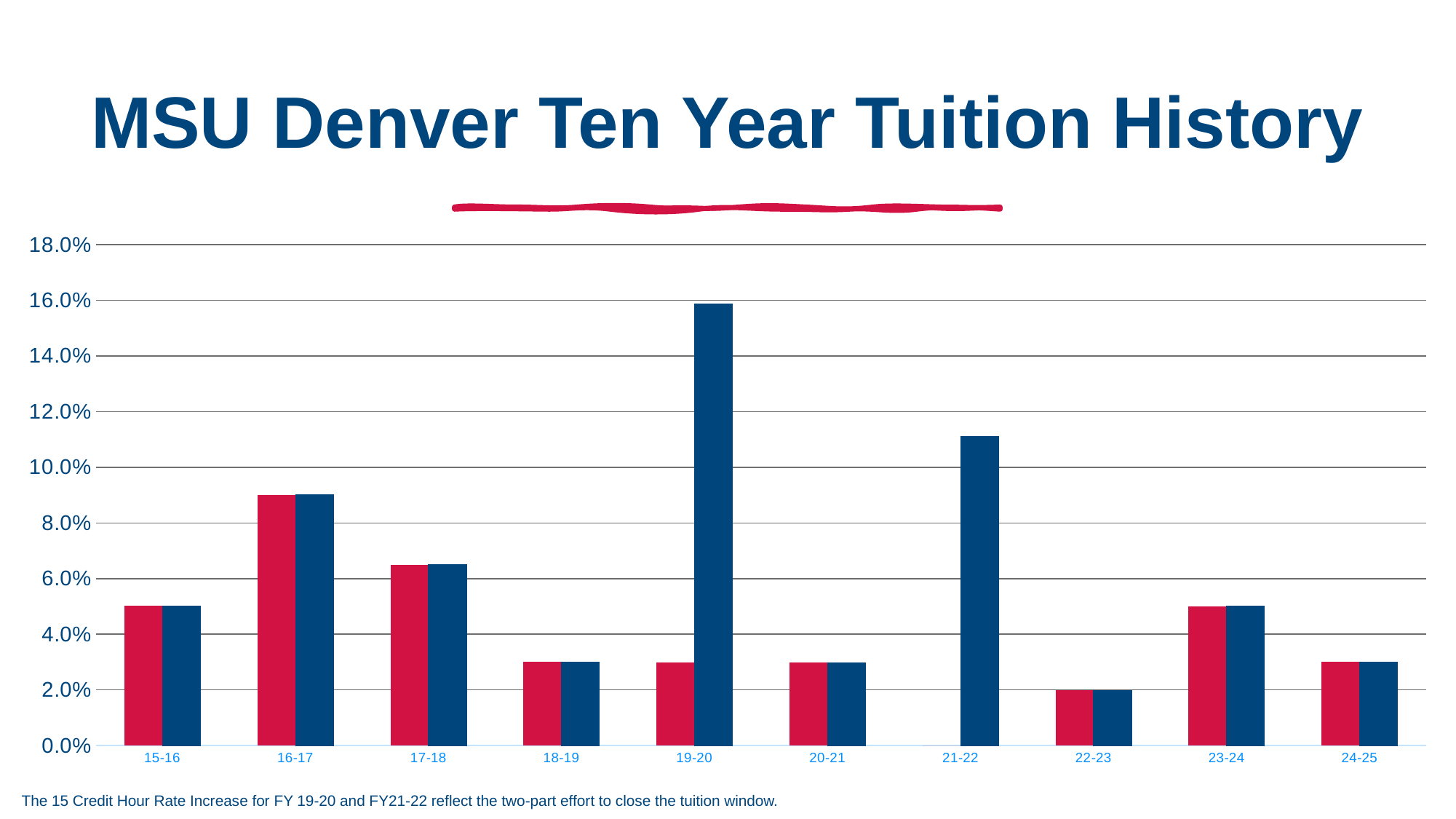
Which fiscal year on the chart has only a blue bar and no red bar? 21-22 How many fiscal-year categories are shown on the x axis? 10 What kind of chart is shown on the slide? bar chart Which fiscal year has the lowest bars on the chart? 22-23 Is the value of the red bar for 18-19 greater or less than 4.0%? less Is the value of the red bar for 16-17 greater or less than 8.0%? greater What is the title of the chart? MSU Denver Ten Year Tuition History Which fiscal year has the tallest bar on the chart? 19-20 Which is larger, the blue bar for 19-20 or the blue bar for 21-22? 19-20 Is the value of the blue bar for 19-20 greater or less than 14.0%? greater Which is larger, the red bar for 16-17 or the red bar for 17-18? 16-17